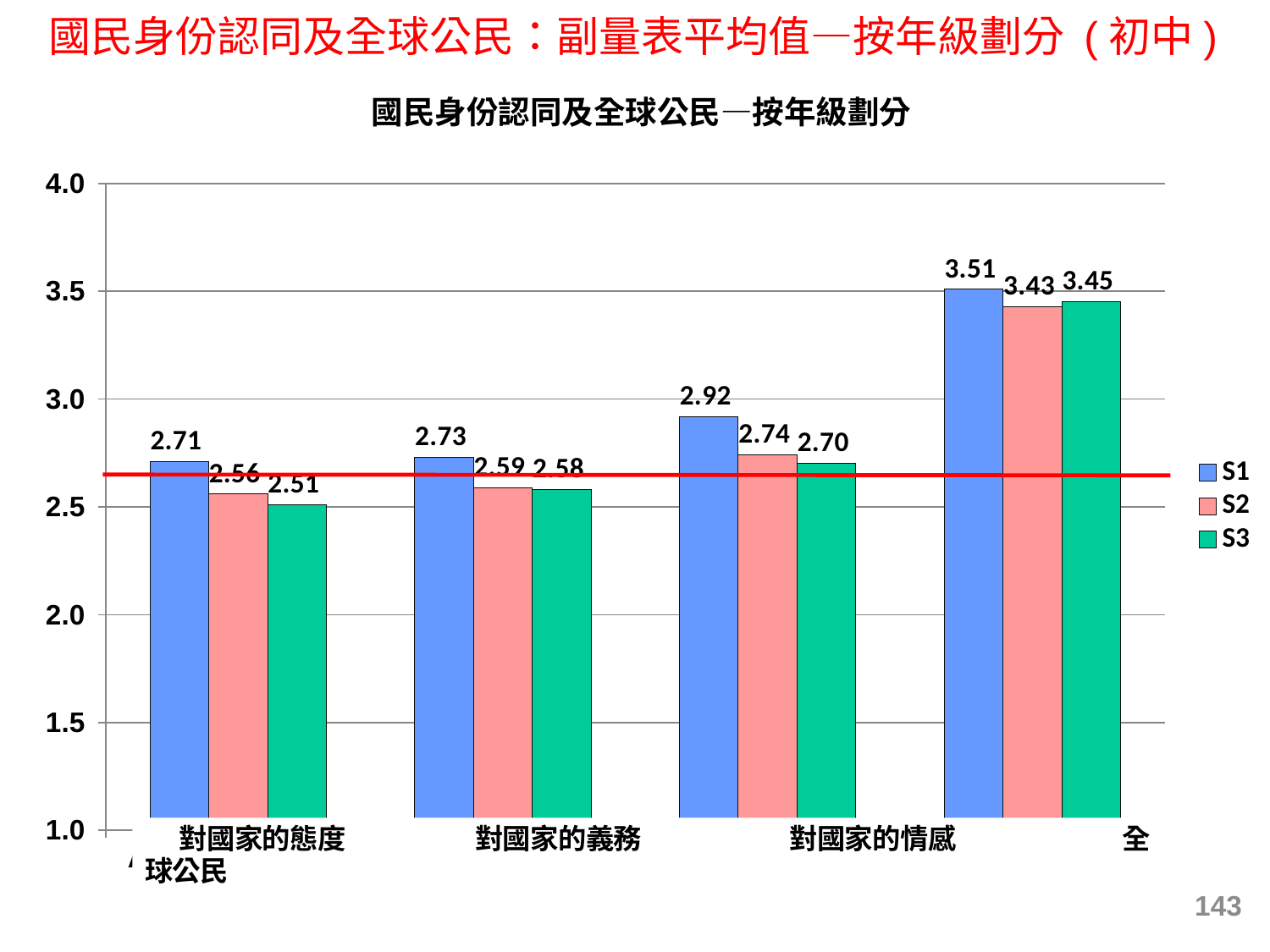
Which category has the highest S1 value? 全球公民 Which is larger in the 全球公民 category, the S2 value or the S3 value? S3 What is the difference between the S1 and S3 values in the 對國家的情感 category? 0.22 What is the value for S1 in the 對國家的態度 category? 2.71 What kind of chart is shown on the slide? bar chart What is the value for S1 in the 全球公民 category? 3.51 Which category has the lowest S3 value? 對國家的態度 What is the value for S2 in the 對國家的情感 category? 2.74 Is the S2 value for 對國家的態度 greater or less than 3.0? less What is the value for S3 in the 對國家的義務 category? 2.58 How many categories are shown on the x axis? 4 How many series does the legend list? 3